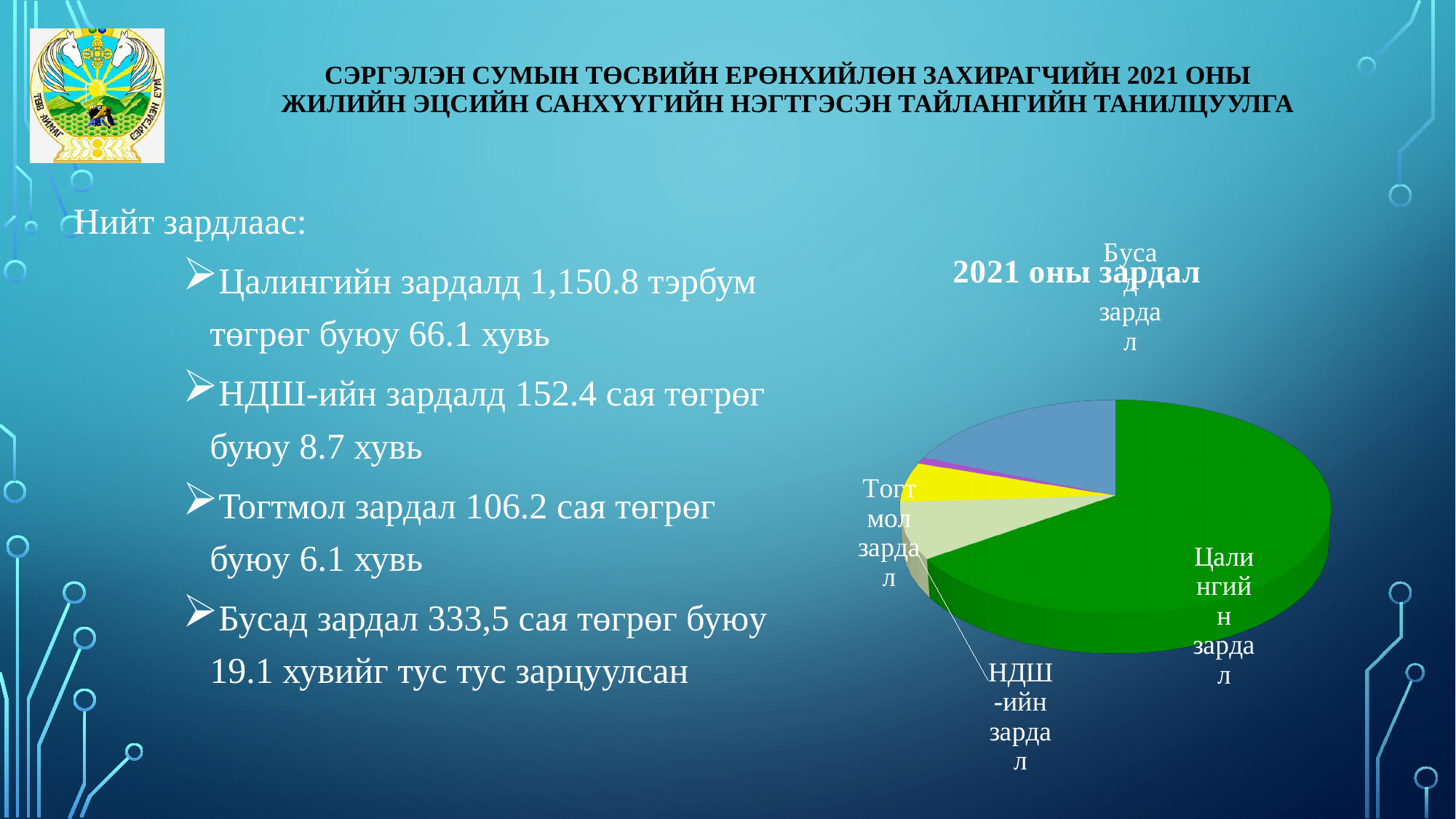
What is the title of the pie chart? 2021 оны зардал Which category has the largest slice in the pie chart? Цалингийн зардал Which slice is larger in the pie chart, Цалингийн зардал or НДШ-ийн зардал? Цалингийн зардал According to the slide, what share of total expenses does Бусад зардал represent? 19.1 хувь According to the slide, what share of total expenses does НДШ-ийн зардал represent? 8.7 хувь What kind of chart is shown on the slide? pie chart According to the slide, what share of total expenses does Цалингийн зардал represent? 66.1 хувь Does the Цалингийн зардал slice take up more or less than half of the pie chart? more What colour is the Цалингийн зардал slice in the pie chart? green Which slice is larger in the pie chart, Цалингийн зардал or Бусад зардал? Цалингийн зардал Which slice is larger in the pie chart, Бусад зардал or Тогтмол зардал? Бусад зардал